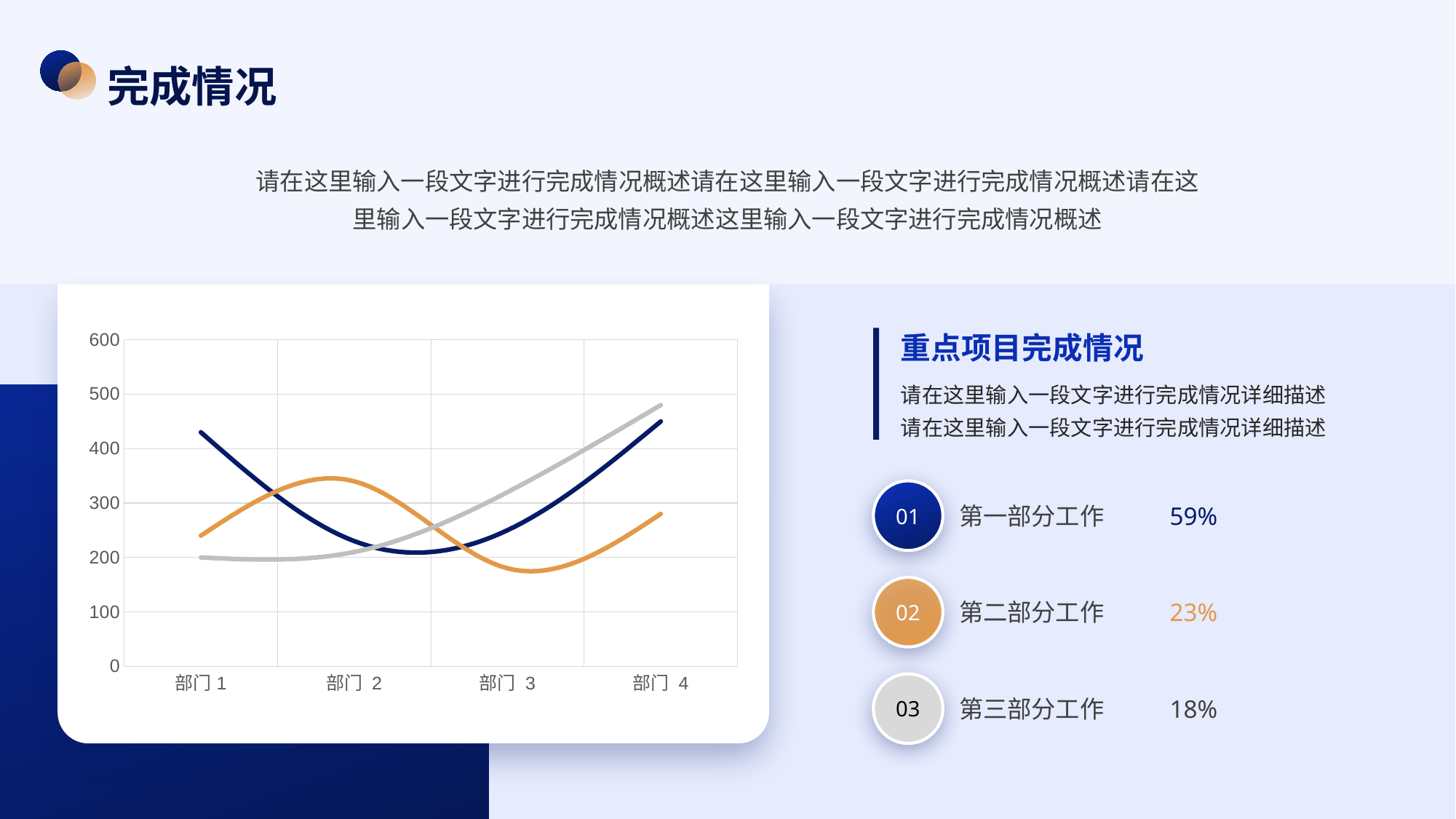
Is the value of the gray line at 部门 1 greater or less than 300? less At 部门 4, which line has the larger value, the gray line or the orange line? the gray line For the gray line, which category has the highest value? 部门 4 How many lines are plotted in the chart? 3 Is the value of the orange line at 部门 2 greater or less than 300? greater What kind of chart is shown on the slide? line chart For the orange line, which category has the lowest value? 部门 3 Is the value of the gray line at 部门 4 greater or less than 400? greater At 部门 1, which line has the larger value, the dark blue line or the gray line? the dark blue line How many categories are shown on the x axis of the chart? 4